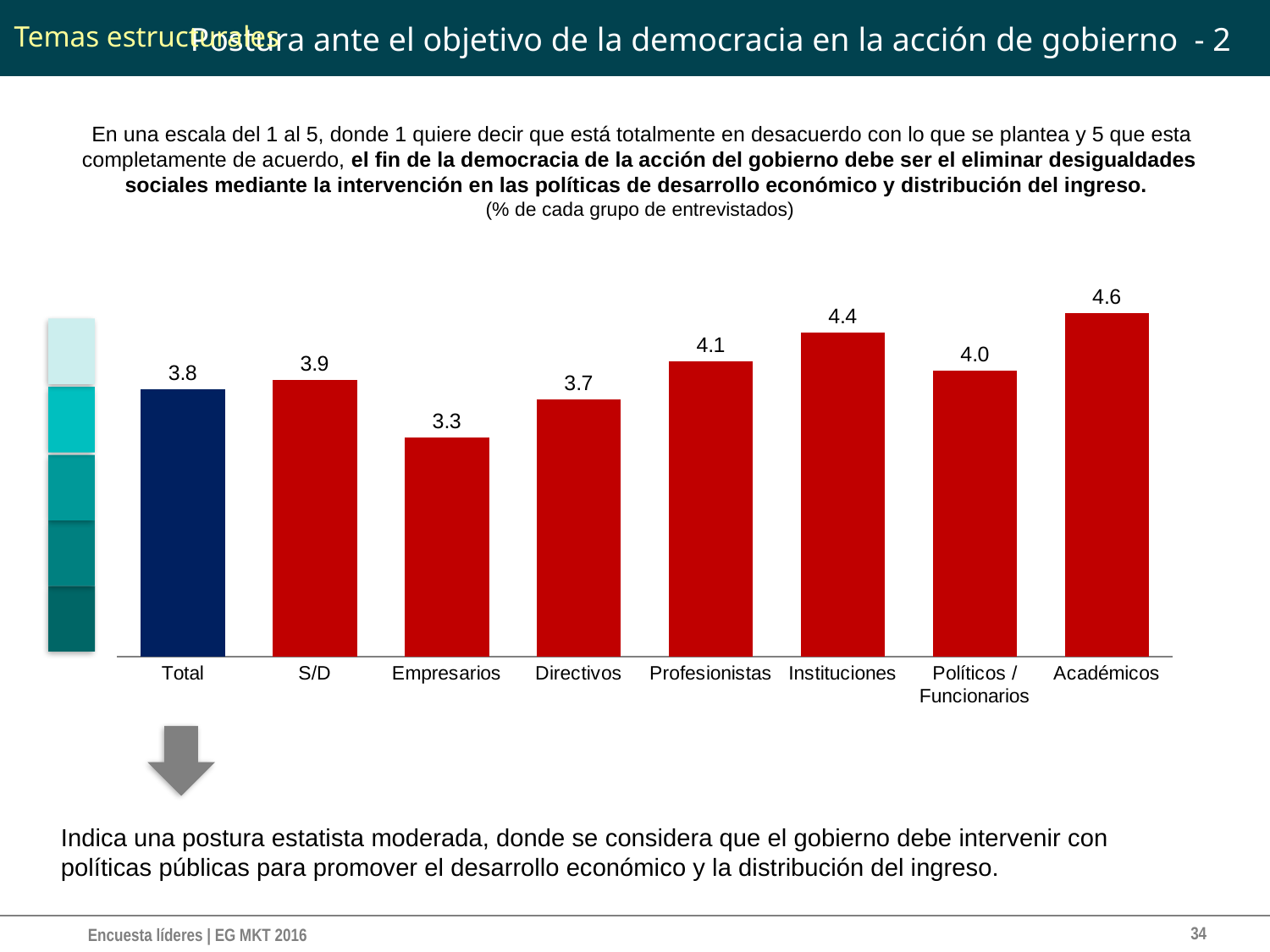
Which category has the highest value? Académicos What is the value for Políticos / Funcionarios? 4.0 Which bar is coloured differently from the others? Total What is the value for Académicos? 4.6 What kind of chart is shown on the slide? Bar chart What is the difference between the values for Instituciones and Total? 0.6 What is the value for Total? 3.8 What is the value for Empresarios? 3.3 How many categories are shown on the x axis? 8 Which is larger, the value for Profesionistas or the value for Directivos? Profesionistas Which category has the lowest value? Empresarios What is the difference between the values for Académicos and Empresarios? 1.3